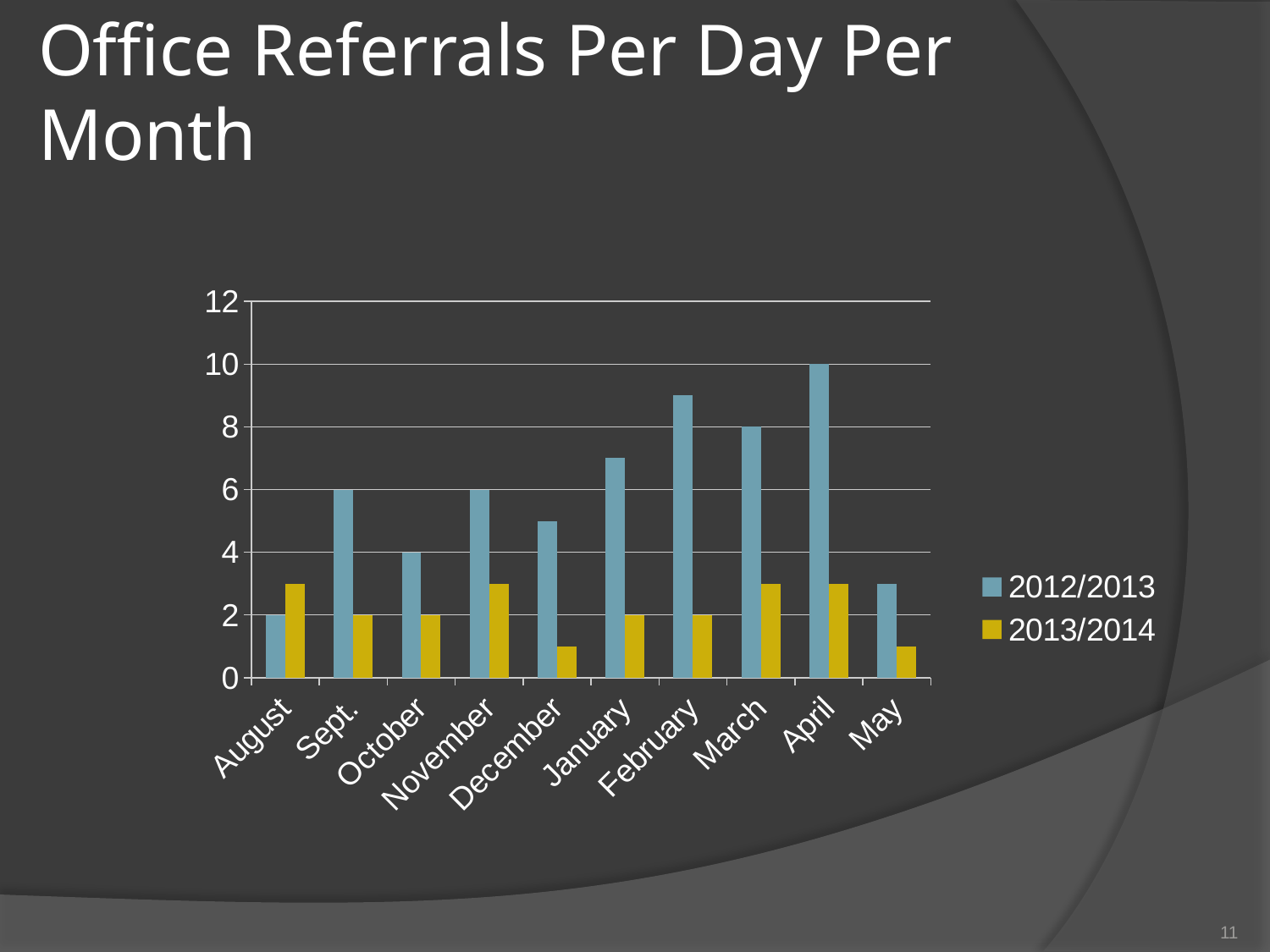
What is the value for October in the 2012/2013 series? 4 Which is larger for Sept., the 2012/2013 value or the 2013/2014 value? 2012/2013 What type of chart is shown on the slide? Bar chart Is the value for December in the 2013/2014 series greater or less than 2? less Which month has the highest value for the 2012/2013 series? April What is the value for January in the 2013/2014 series? 2 Which month has the lowest value for the 2012/2013 series? August What is the value for April in the 2012/2013 series? 10 How many months are shown on the x axis? 10 What is the difference between the 2012/2013 values for April and March? 2 How many series does the legend list? 2 Is the value for February in the 2012/2013 series greater or less than 8? greater